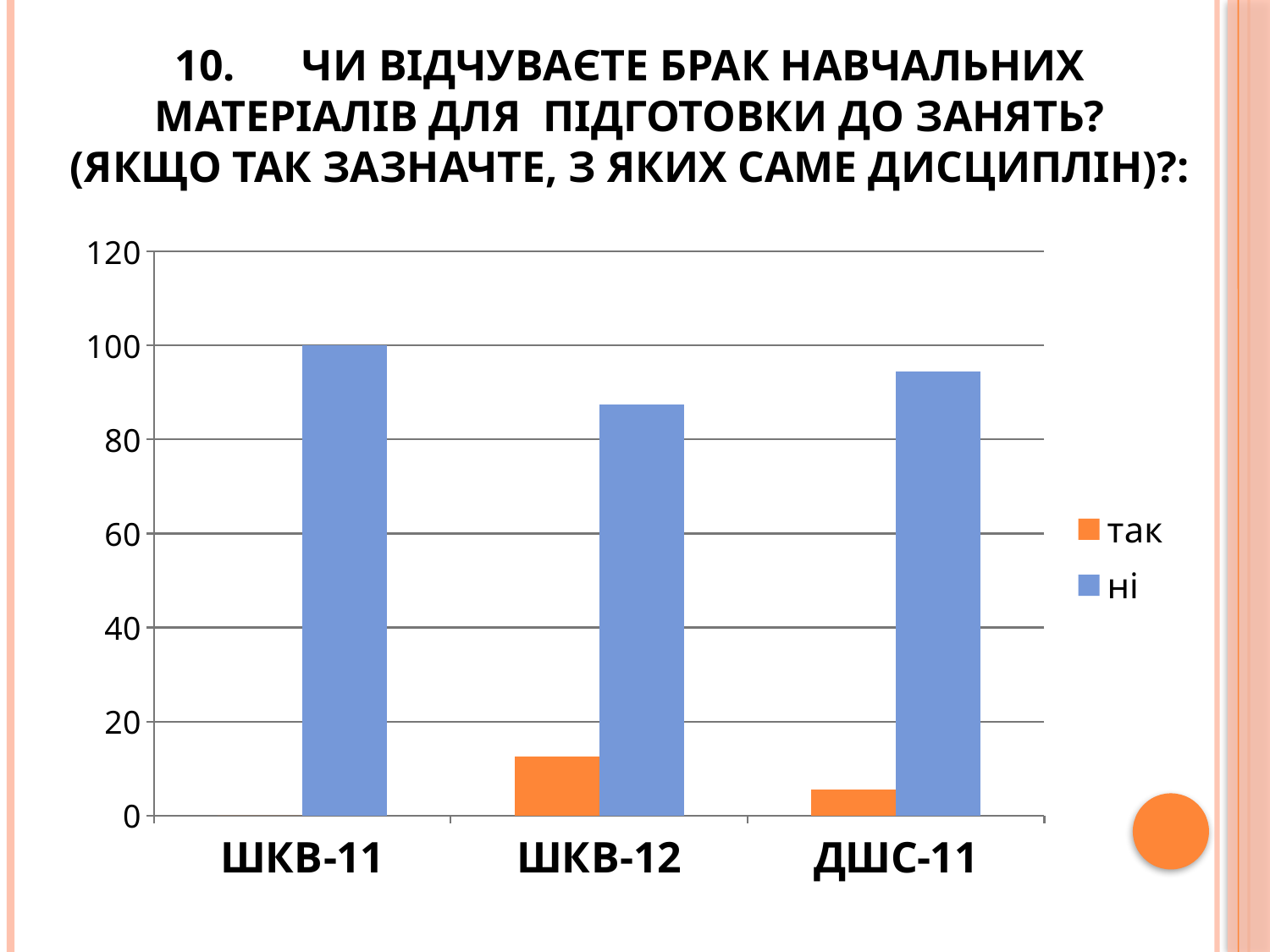
Which is larger: the "так" value for ШКВ-12 or the "так" value for ДШС-11? ШКВ-12 Which category has the highest value for "так"? ШКВ-12 Is the value of "ні" for ШКВ-12 greater or less than 80? greater Which category has the lowest value for "ні"? ШКВ-12 What are the two entries in the chart's legend? так, ні Which category has the highest value for "ні"? ШКВ-11 Is the value of "так" for ДШС-11 greater or less than 20? less Is the value of "ні" for ДШС-11 greater or less than 100? less How many categories are shown on the x axis of the chart? 3 What kind of chart is shown on the slide? bar chart How many series does the chart's legend list? 2 What is the value of "ні" for ШКВ-11? 100